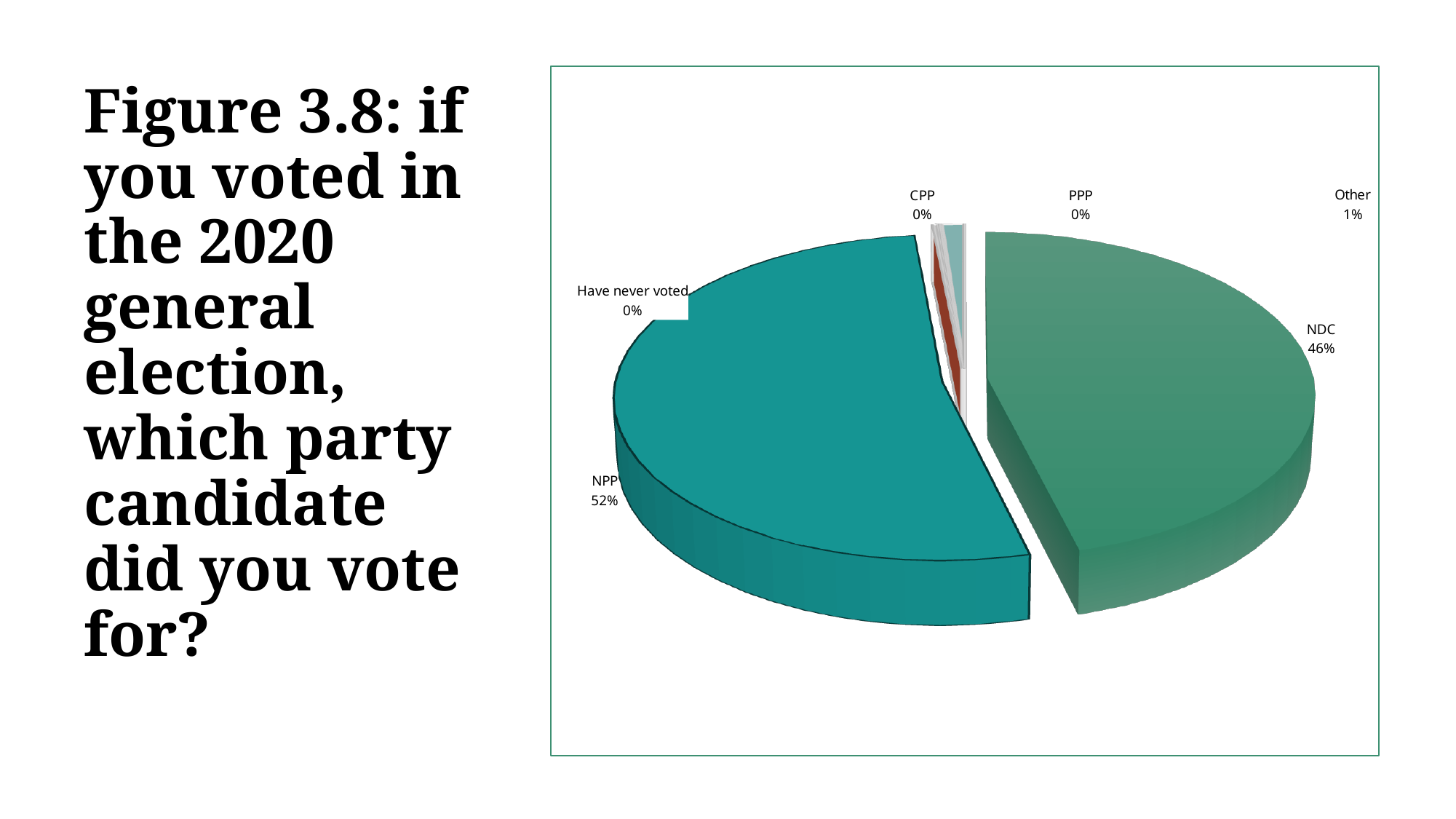
How many categories are labelled on the pie chart? 6 What share of the pie does NPP have? 52% What share of the pie does PPP have? 0% What share of the pie does NDC have? 46% What is the title of the figure on the slide? Figure 3.8: if you voted in the 2020 general election, which party candidate did you vote for? Which category has the largest share of the pie? NPP Which is larger, the share for NDC or the share for Other? NDC What is the combined share of NPP and NDC? 98% What share of the pie does CPP have? 0% What share of the pie does Other have? 1% What kind of chart is shown on the slide? pie chart What is the difference between the NPP share and the NDC share? 6%